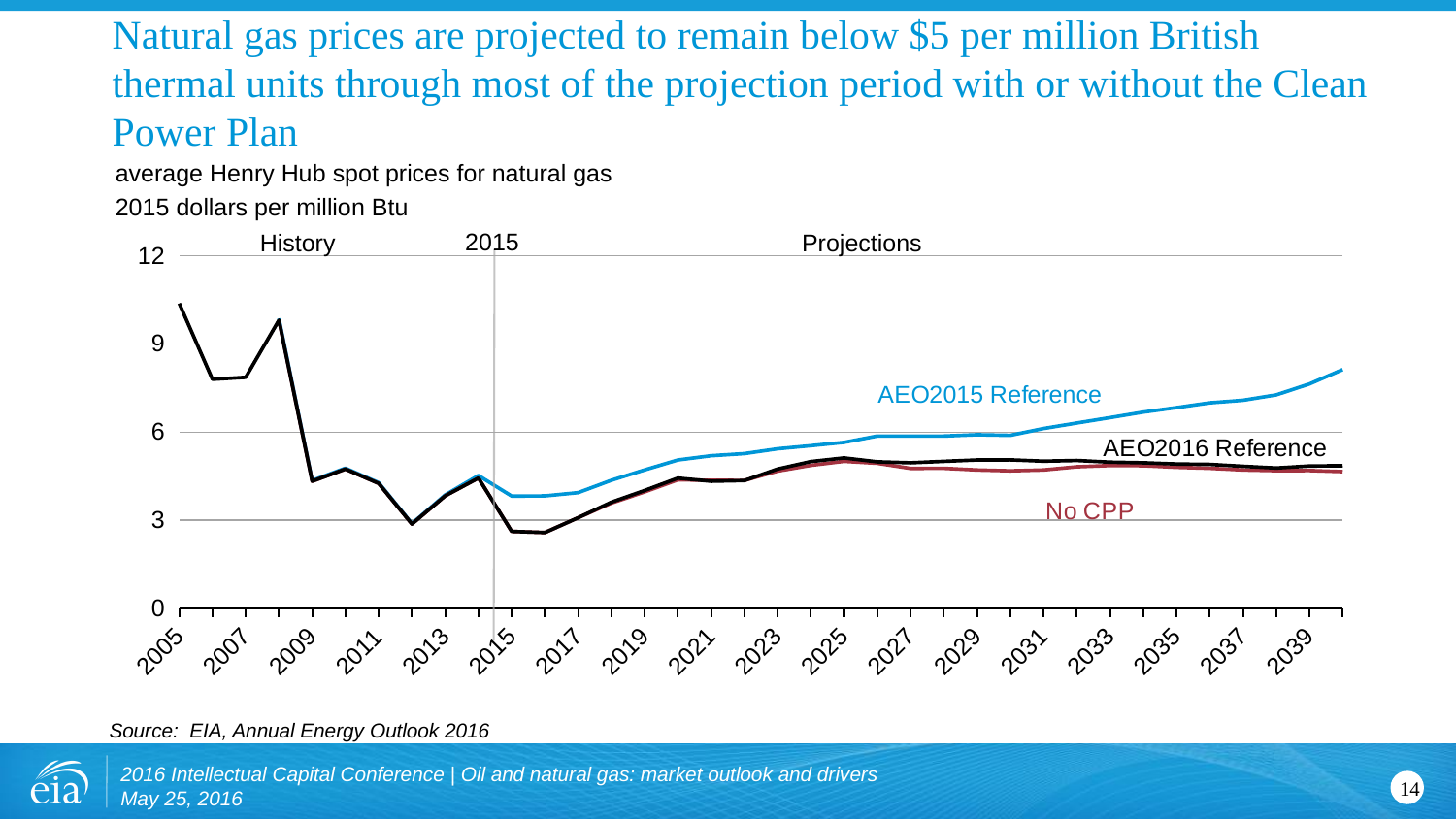
What units are the prices shown in, according to the subtitle? 2015 dollars per million Btu Does the AEO2015 Reference line rise or fall from 2016 to 2039? rise How many series are labelled on the chart? 3 What kind of chart is shown on the slide? line chart What is the source cited for the chart? EIA, Annual Energy Outlook 2016 Is the historical price in 2009 greater or less than 6? less Is the AEO2015 Reference value in 2039 greater or less than 6? greater Is the historical price in 2005 greater or less than 9? greater Which year in the history period has the highest price? 2005 Which series has the highest value in 2039? AEO2015 Reference In 2039, which is larger: the AEO2015 Reference value or the AEO2016 Reference value? AEO2015 Reference